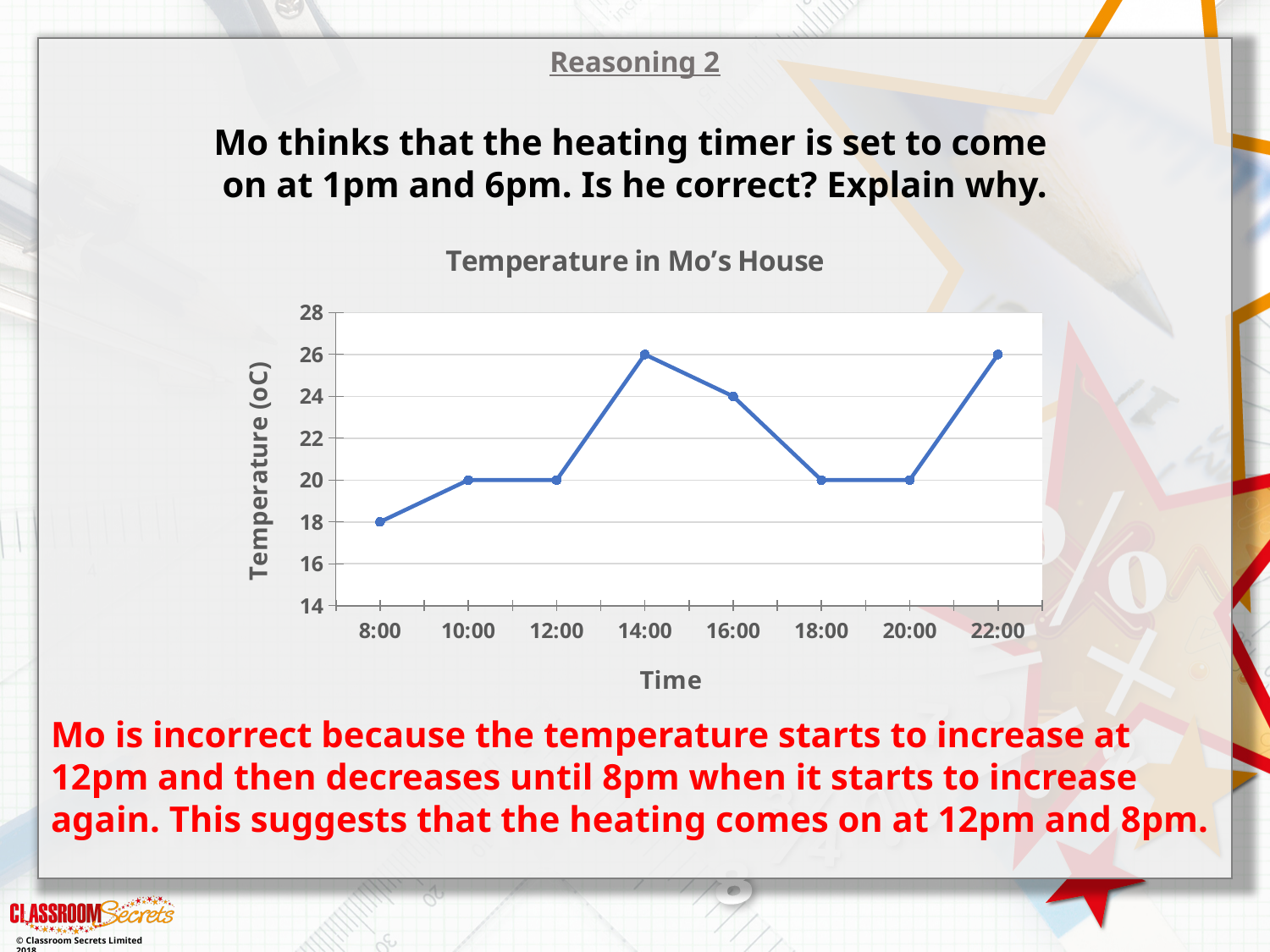
What is the temperature at 14:00? 26 What is the difference between the temperature at 14:00 and the temperature at 8:00? 8 What is the title of the chart? Temperature in Mo's House What kind of chart is shown on the slide? line chart What is the temperature at 18:00? 20 How many data points are plotted on the chart? 8 At which time is the temperature lowest? 8:00 Does the temperature rise or fall between 14:00 and 18:00? fall What is the temperature at 8:00? 18 What is the temperature at 16:00? 24 Which is higher, the temperature at 16:00 or at 18:00? 16:00 What is the label on the x axis? Time